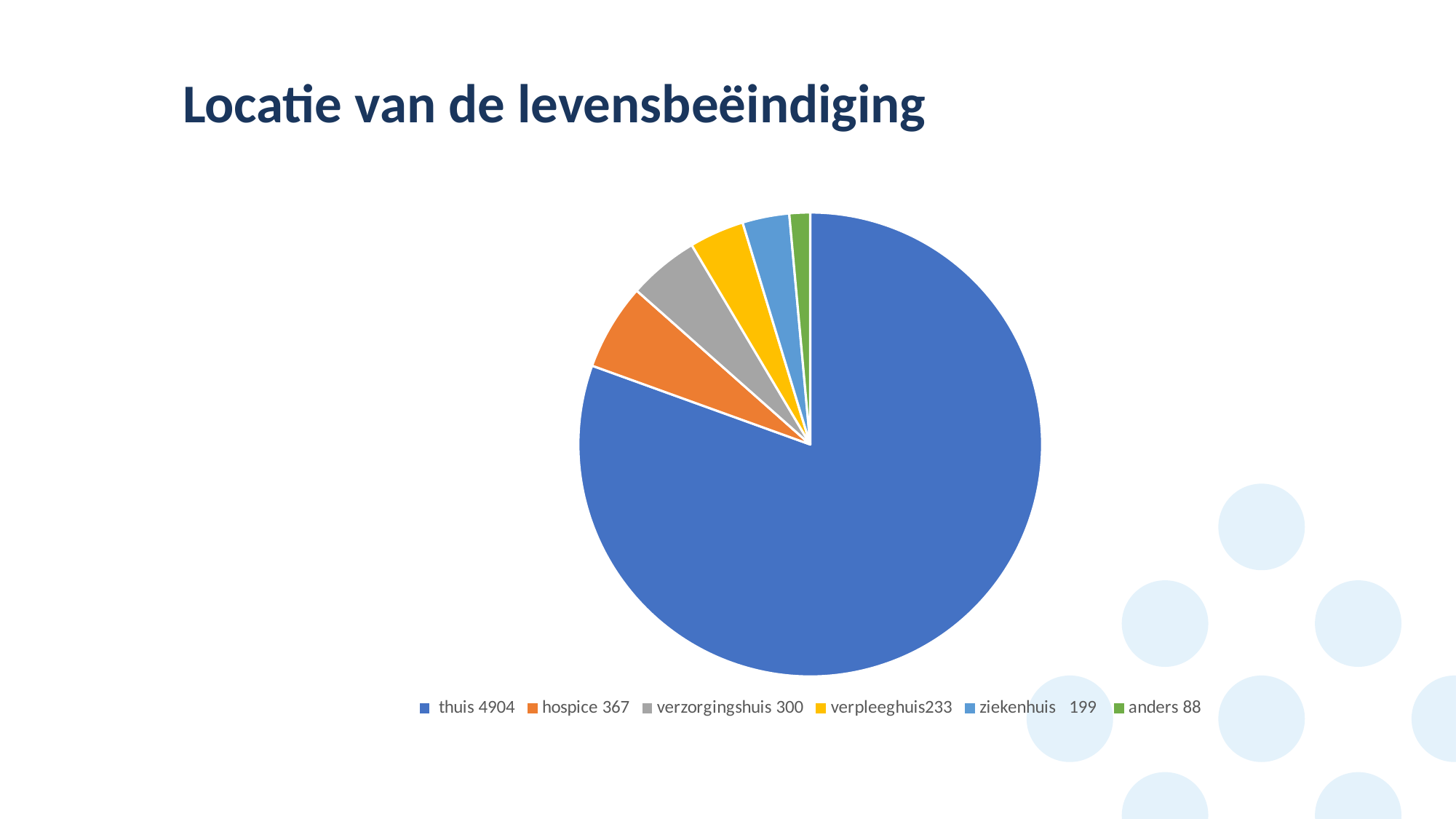
Which category has the smallest slice? anders What is the value for ziekenhuis? 199 What is the value for thuis? 4904 What is the value for hospice? 367 What is the difference between the values for hospice and verzorgingshuis? 67 Which category has the largest slice? thuis What colour is the slice for verpleeghuis? yellow What is the title of the chart? Locatie van de levensbeëindiging Which is larger, the value for verpleeghuis or the value for ziekenhuis? verpleeghuis What is the value for verzorgingshuis? 300 What kind of chart is shown on the slide? pie chart How many slices does the pie chart have? 6